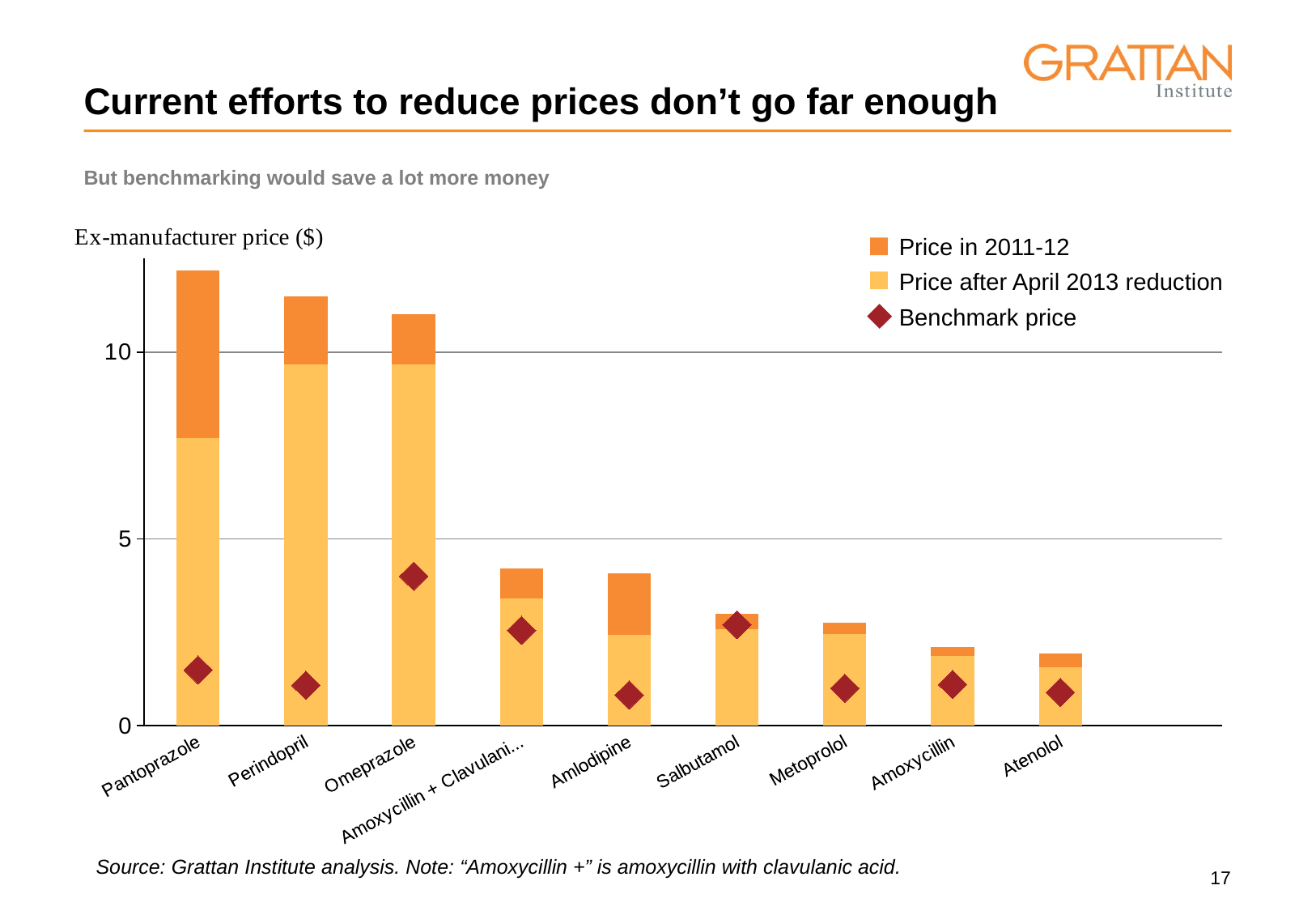
Do the prices in 2011-12 generally rise or fall moving from left to right along the x axis? fall Which is larger: the price in 2011-12 for Pantoprazole or for Amlodipine? Pantoprazole Is the price in 2011-12 for Pantoprazole greater or less than 10? greater Which drug has the highest price in 2011-12? Pantoprazole What is the label on the vertical axis of the chart? Ex-manufacturer price ($) How many series does the chart's legend list? 3 Which drug has the highest benchmark price? Omeprazole How many drugs are shown along the x axis of the chart? 9 Is the price in 2011-12 for Amlodipine greater or less than 5? less Is the benchmark price for Omeprazole greater or less than 5? less What kind of chart is shown on the slide? bar chart